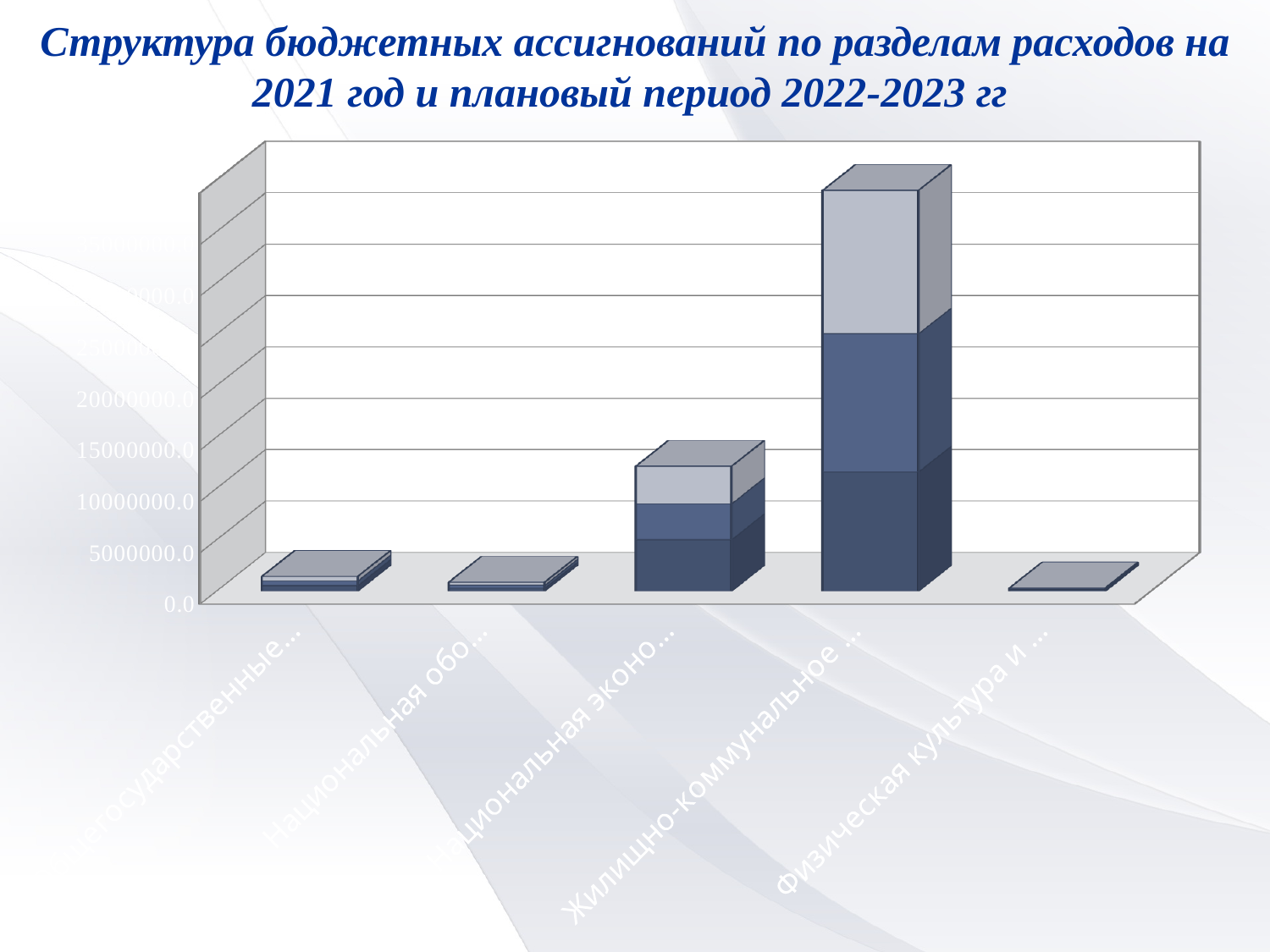
Which bar is taller: 'Национальная эконо...' or 'Жилищно-коммунальное ...'? Жилищно-коммунальное ... Is the total value of the bar for 'Жилищно-коммунальное ...' greater or less than 30000000.0? greater How many categories are plotted along the x axis of the chart? 5 Is the total value of the bar for 'Национальная эконо...' greater or less than 15000000.0? less Is the total value of the bar for 'Национальная эконо...' greater or less than 10000000.0? greater What kind of chart is shown on the slide? bar chart Which category has the tallest bar in the chart? Жилищно-коммунальное ... How many stacked segments make up the bar for 'Жилищно-коммунальное ...'? 3 What is the title of the slide containing the chart? Структура бюджетных ассигнований по разделам расходов на 2021 год и плановый период 2022-2023 гг Which bar is taller: 'Общегосударственные...' or 'Национальная эконо...'? Национальная эконо...